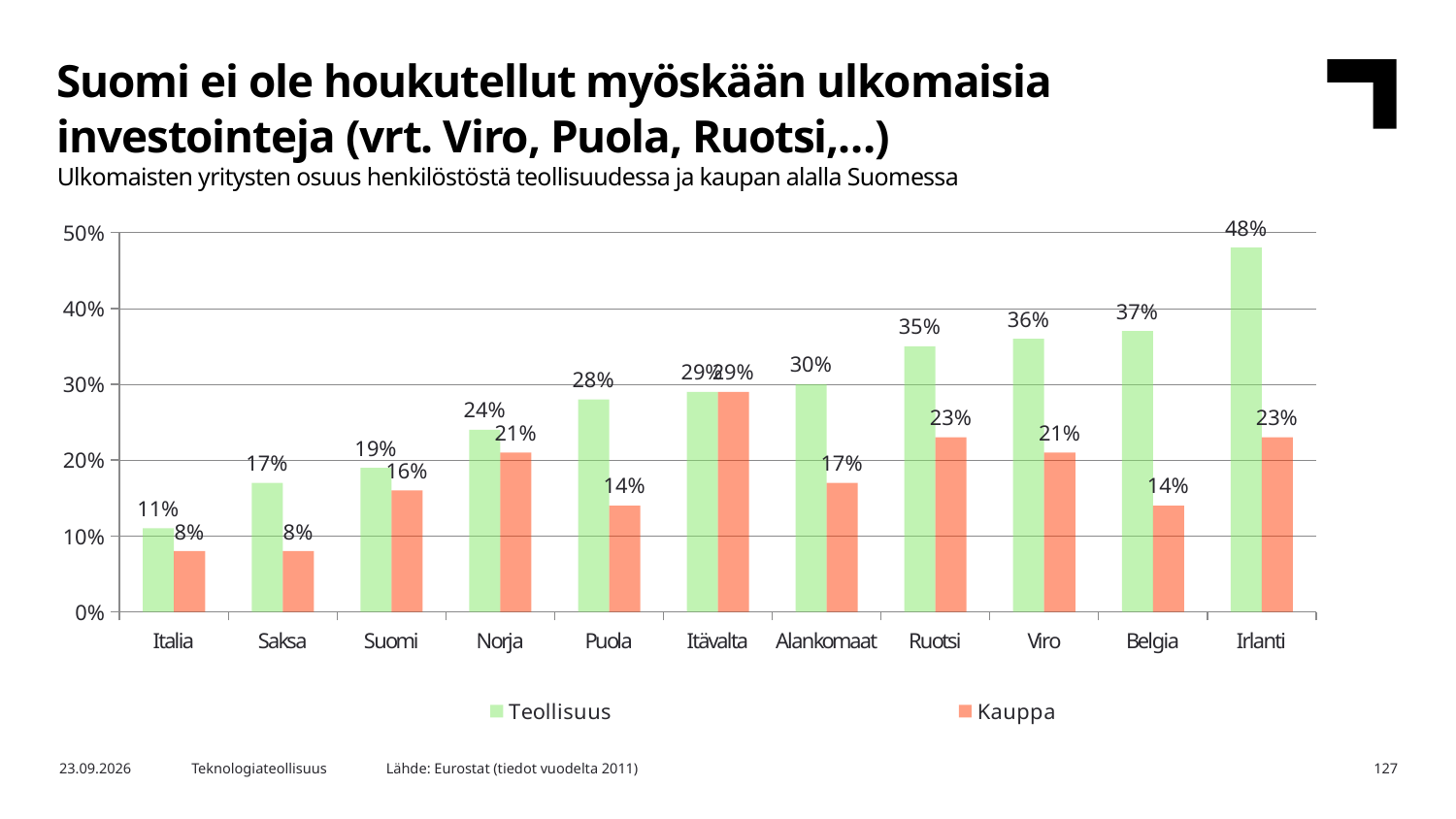
What is the Teollisuus value for Suomi? 19% Is the Teollisuus value for Ruotsi greater or less than 30%? greater How many countries are shown on the x axis? 11 Do the Teollisuus values rise or fall from Italia to Irlanti along the x axis? Rise What kind of chart is shown on the slide? Bar chart Which country has the highest Teollisuus value? Irlanti Which series is shown in orange in the legend? Kauppa How many series does the legend list? 2 What is the difference between the Teollisuus and Kauppa values for Puola? 14% Which country has the lowest Teollisuus value? Italia What is the Kauppa value for Viro? 21% Which is larger for Norja, the Teollisuus value or the Kauppa value? Teollisuus